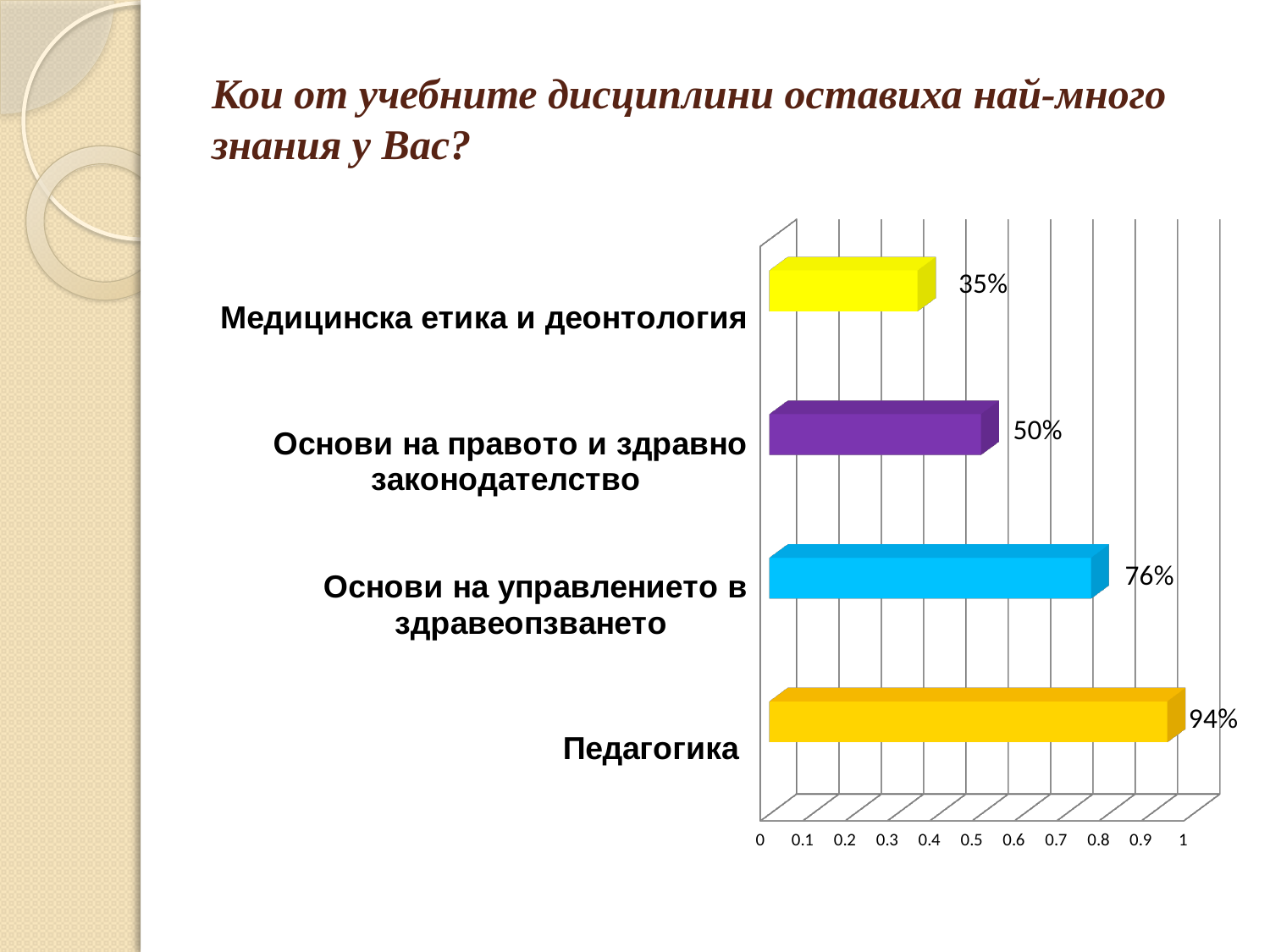
What is the value for Педагогика? 94% What is the difference between the values for Педагогика and Медицинска етика и деонтология? 59% What is the title of the slide? Кои от учебните дисциплини оставиха най-много знания у Вас? Which category has the highest value? Педагогика What is the value for Медицинска етика и деонтология? 35% How many categories are shown in the chart? 4 Which is larger, the value for Основи на правото и здравно законодателство or the value for Основи на управлението в здравеопзването? Основи на управлението в здравеопзването Which category has the lowest value? Медицинска етика и деонтология What is the value for Основи на правото и здравно законодателство? 50% What is the difference between the values for Основи на управлението в здравеопзването and Основи на правото и здравно законодателство? 26% What is the value for Основи на управлението в здравеопзването? 76% What kind of chart is shown on the slide? Bar chart